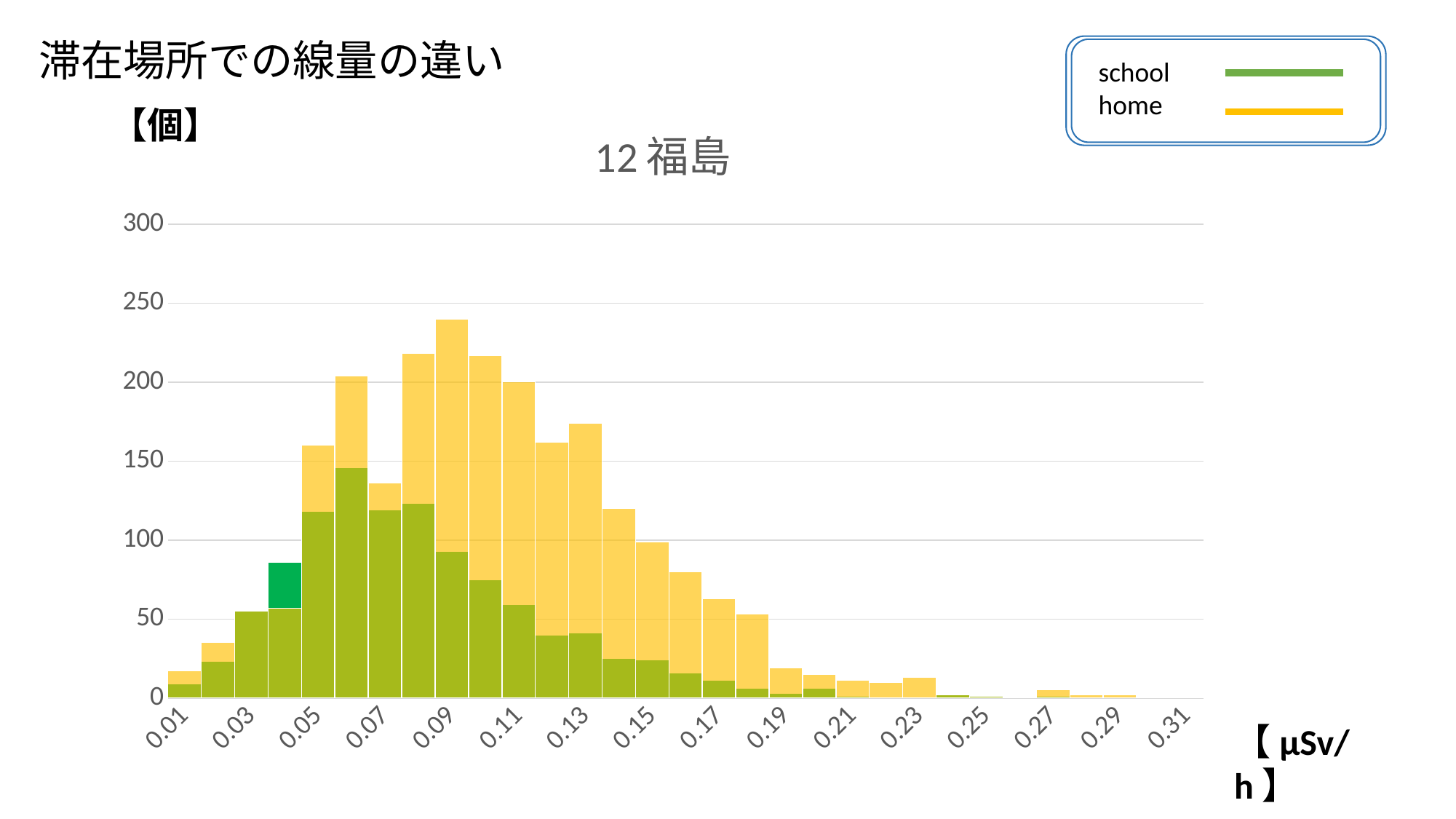
What kind of chart is shown on the slide? bar chart Do the home values rise or fall along the x axis from 0.09 to 0.19? fall At which x-axis value does the school series reach its highest bar? 0.06 At which x-axis value does the home series reach its highest bar? 0.09 At 0.11, which series has the larger value, school or home? home How many series does the legend list? 2 What is the title shown above the chart? 12 福島 Is the school value at 0.06 greater or less than 100? greater Is the home value at 0.15 greater or less than 150? less What are the two series named in the legend? school and home Is the school value at 0.13 greater or less than 50? less